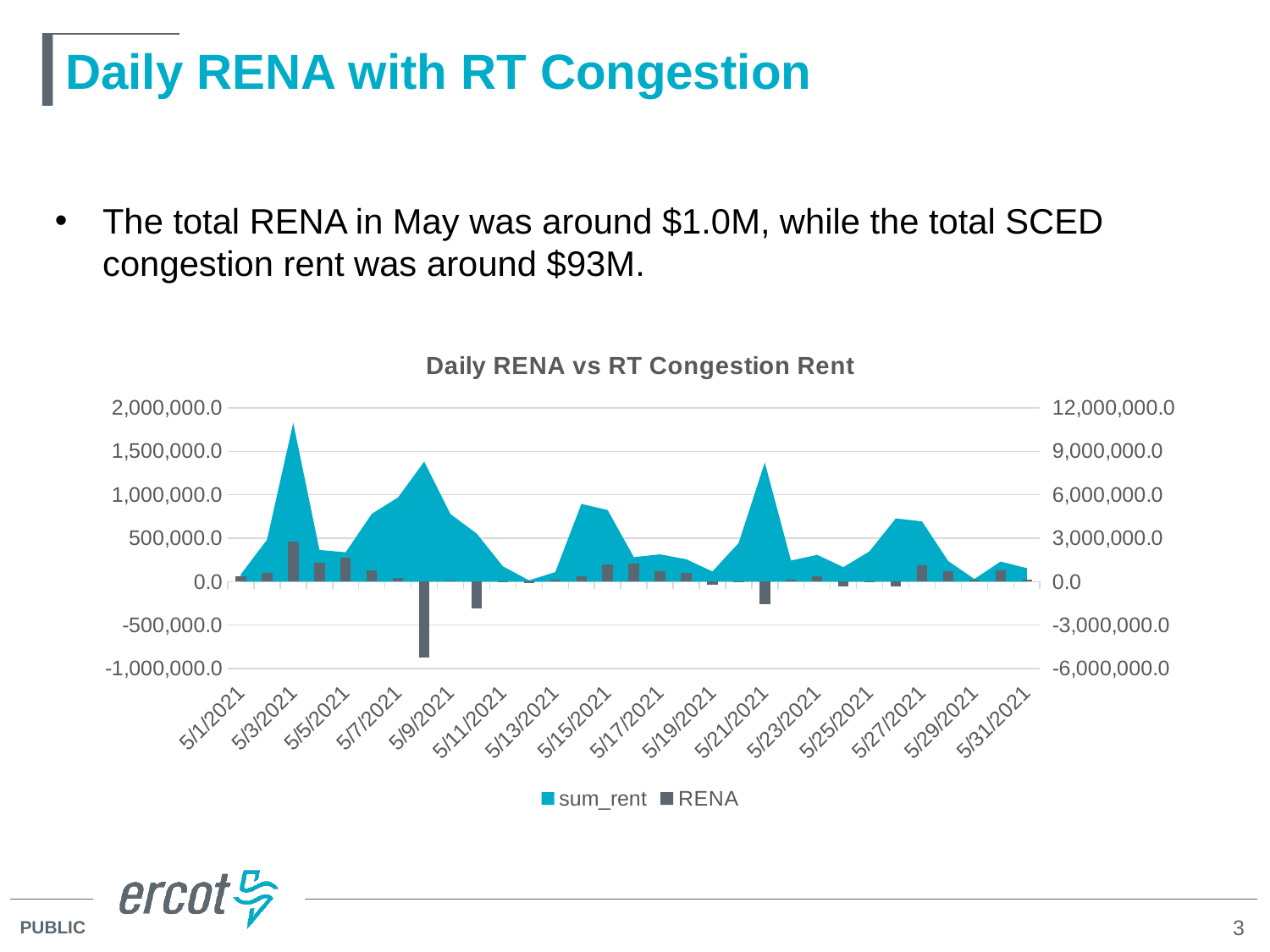
What is the first date label on the x axis of the chart? 5/1/2021 On which date does the RENA series have its lowest (most negative) bar? 5/8/2021 What is the last date label on the x axis of the chart? 5/31/2021 How many date labels are shown on the x axis of the chart? 16 On which date does the sum_rent series reach its highest peak? 5/3/2021 Does the sum_rent series rise or fall from 5/3/2021 to 5/5/2021? Fall Which is higher for sum_rent: the peak at 5/3/2021 or the peak at 5/21/2021? 5/3/2021 What kind of chart is shown on the slide? A combination chart with an area series and a bar series Does the sum_rent series rise or fall from 5/1/2021 to 5/3/2021? Rise How many series does the chart legend list? 2 What is the title of the chart on the slide? Daily RENA vs RT Congestion Rent What are the two series named in the chart legend? sum_rent and RENA